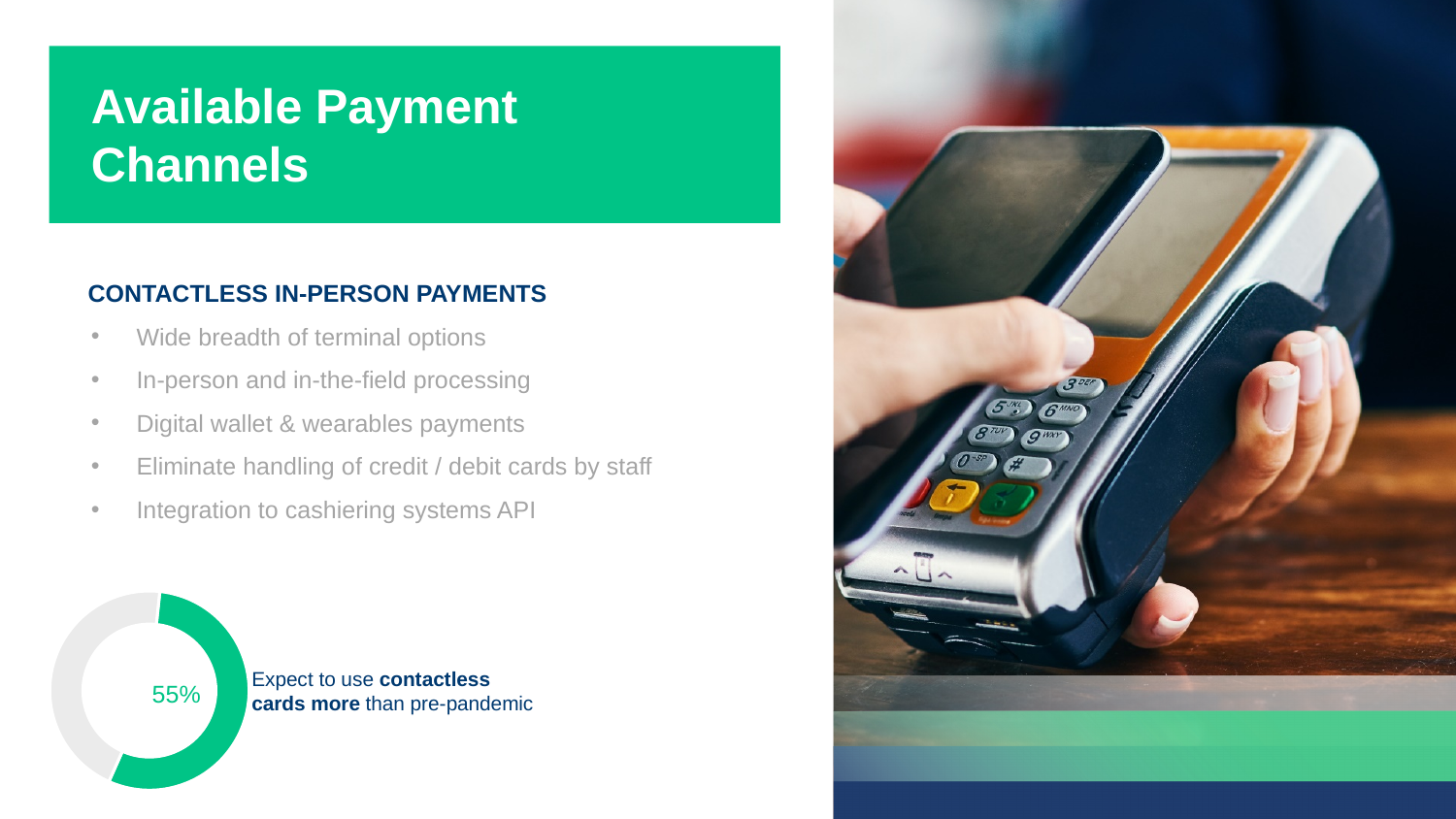
What share of the donut chart does the green segment represent? 55% What percentage is shown in the centre of the donut chart? 55% What kind of chart is shown at the bottom left of the slide? Donut (pie) chart Which segment of the donut chart is larger, the green one or the grey one? The green one According to the text next to the donut chart, what does the 55% represent? Expect to use contactless cards more than pre-pandemic How many segments does the donut chart have? 2 Is the grey (remaining) portion of the donut chart greater or less than 50%? less Is the value shown in the donut chart greater or less than 50%? greater What colour is the highlighted segment of the donut chart? Green